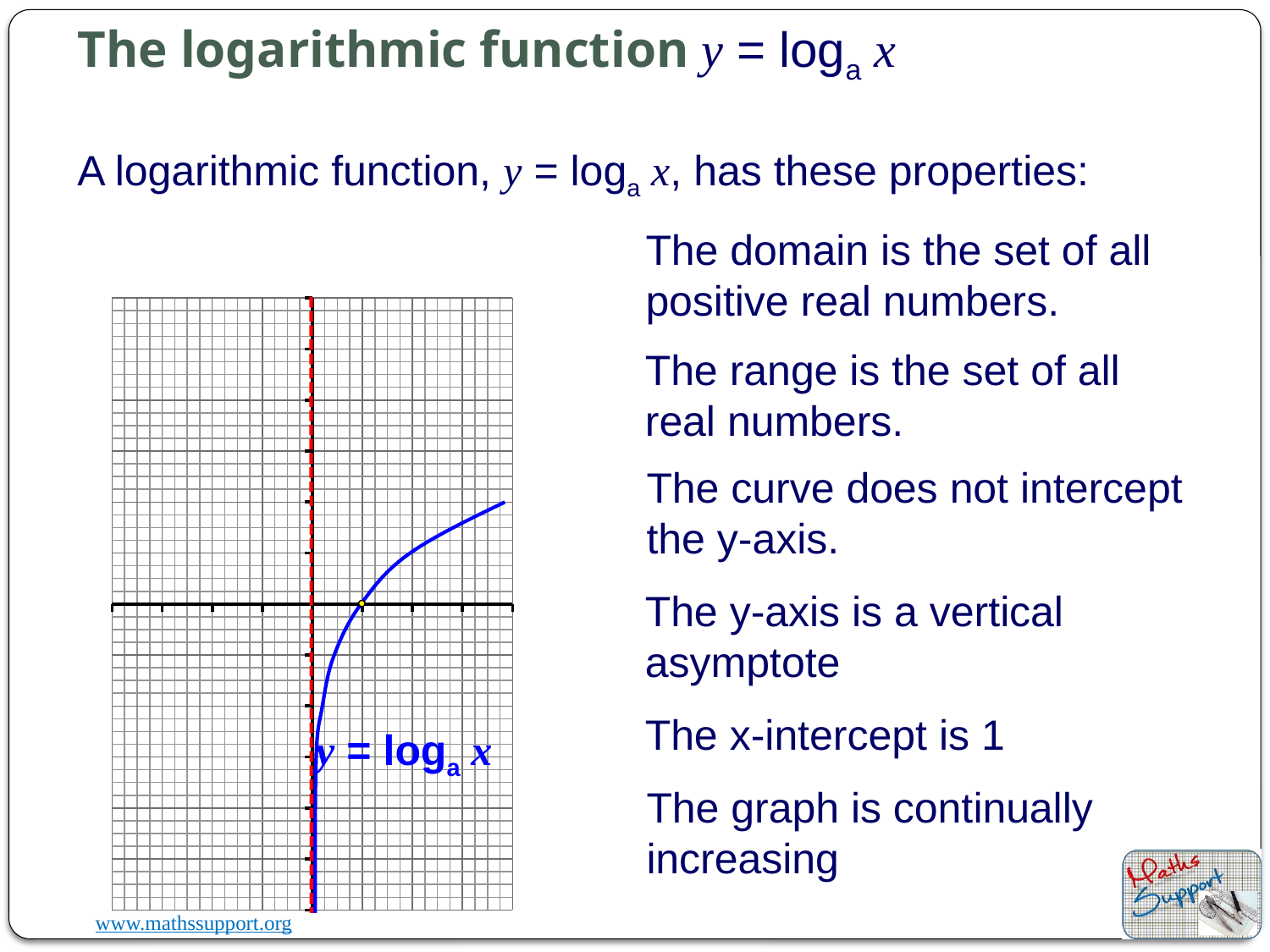
Which axis does the red dashed line on the graph mark as the vertical asymptote? The y-axis Does the curve on the graph rise or fall as x increases? Rises What is the x-intercept of the curve shown on the graph? 1 What kind of graph is shown on the slide? A line graph (curve) Does the curve on the graph cross the y-axis? No What colour is the curve plotted on the graph? Blue How many curves are plotted on the graph? 1 What function is the curve on the graph labelled as? y = log_a x